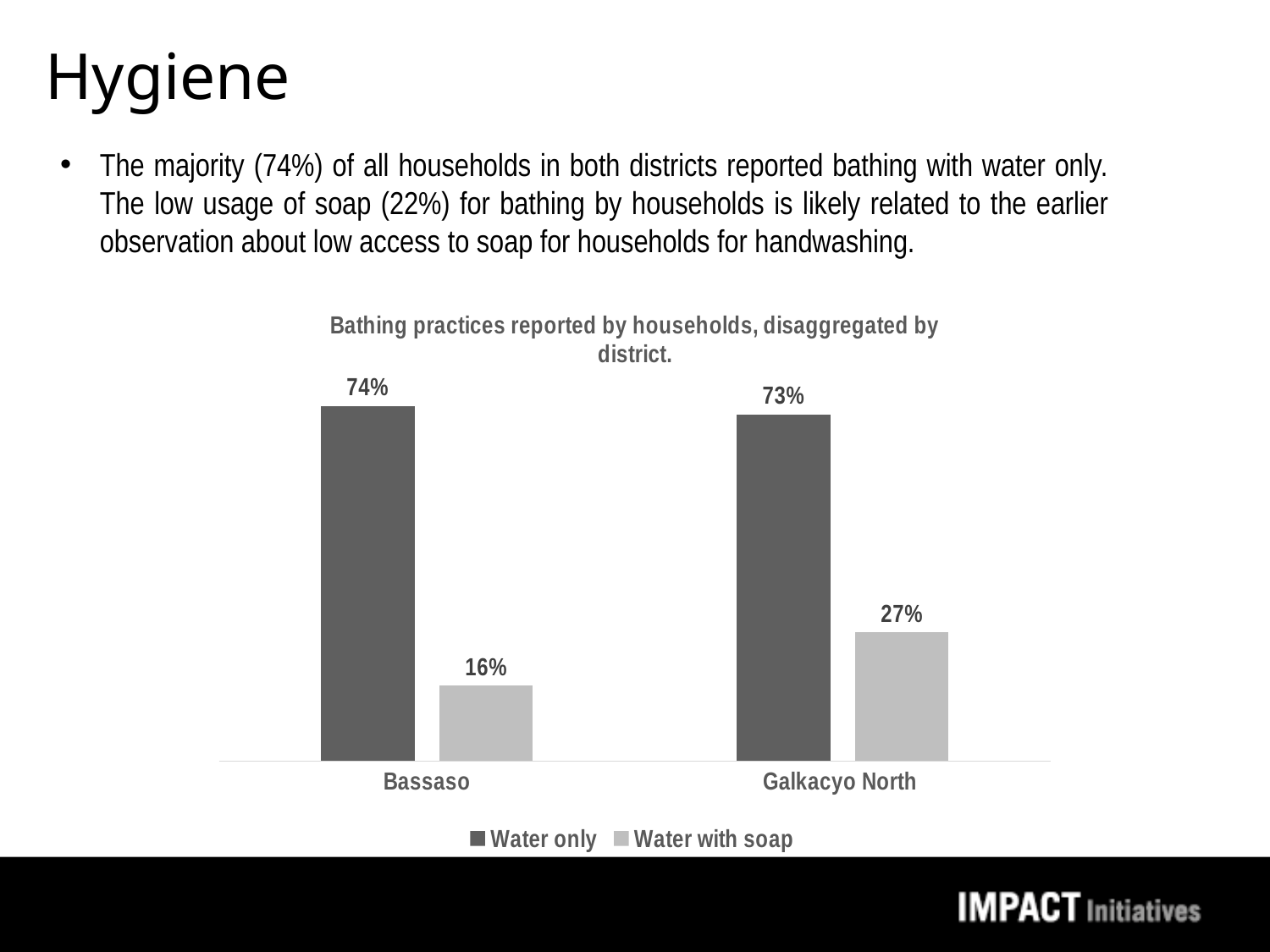
What is the value for Water only in Galkacyo North? 73% What is the difference between the Water with soap values for Galkacyo North and Bassaso? 11% In Galkacyo North, which is larger: Water only or Water with soap? Water only What is the value for Water with soap in Bassaso? 16% What percentage of households in Bassaso reported bathing with water only? 74% How many series does the chart legend list? 2 What percentage of households in Galkacyo North reported bathing with water with soap? 27% What is the difference between Water only and Water with soap in Bassaso? 58% Which district has the lower value for Water with soap? Bassaso How many districts are shown on the x axis of the chart? 2 Which district has the higher value for Water with soap? Galkacyo North What type of chart is shown on the slide? Bar chart